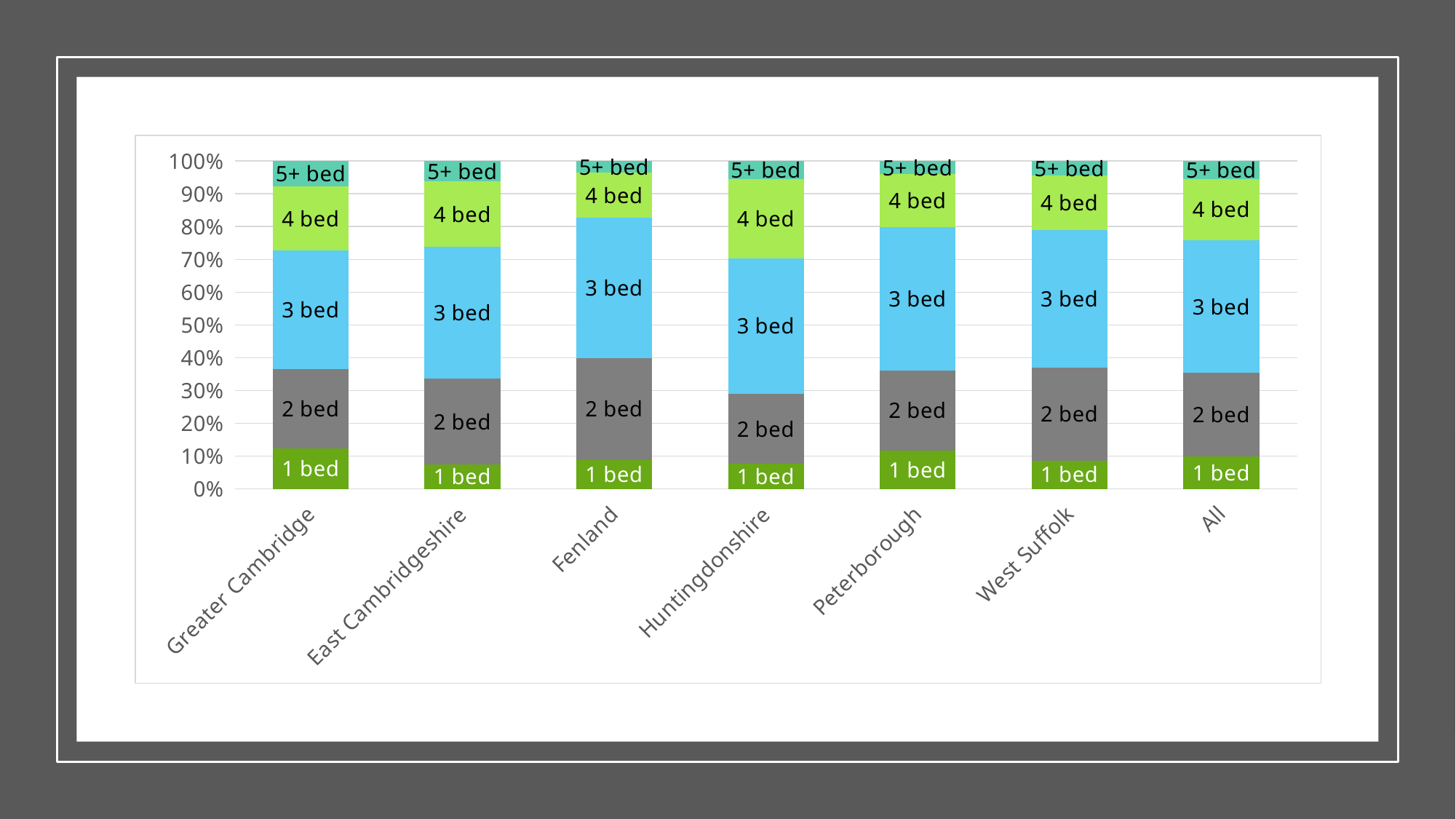
What kind of chart is shown on the slide? Stacked bar chart Is the 1 bed share for Fenland greater or less than 10%? less Which has the larger 1 bed share, Greater Cambridge or Fenland? Greater Cambridge What colour are the 3 bed segments in the bars? Blue Is the 5+ bed share for Greater Cambridge greater or less than 10%? less How many categories are shown along the x axis? 7 Is the 3 bed share for Fenland greater or less than 40%? greater Which category has the smallest 4 bed share? Fenland Which has the larger 2 bed share, Fenland or Huntingdonshire? Fenland Which category has the largest 4 bed share? Huntingdonshire How many bedroom-size segments make up each stacked bar? 5